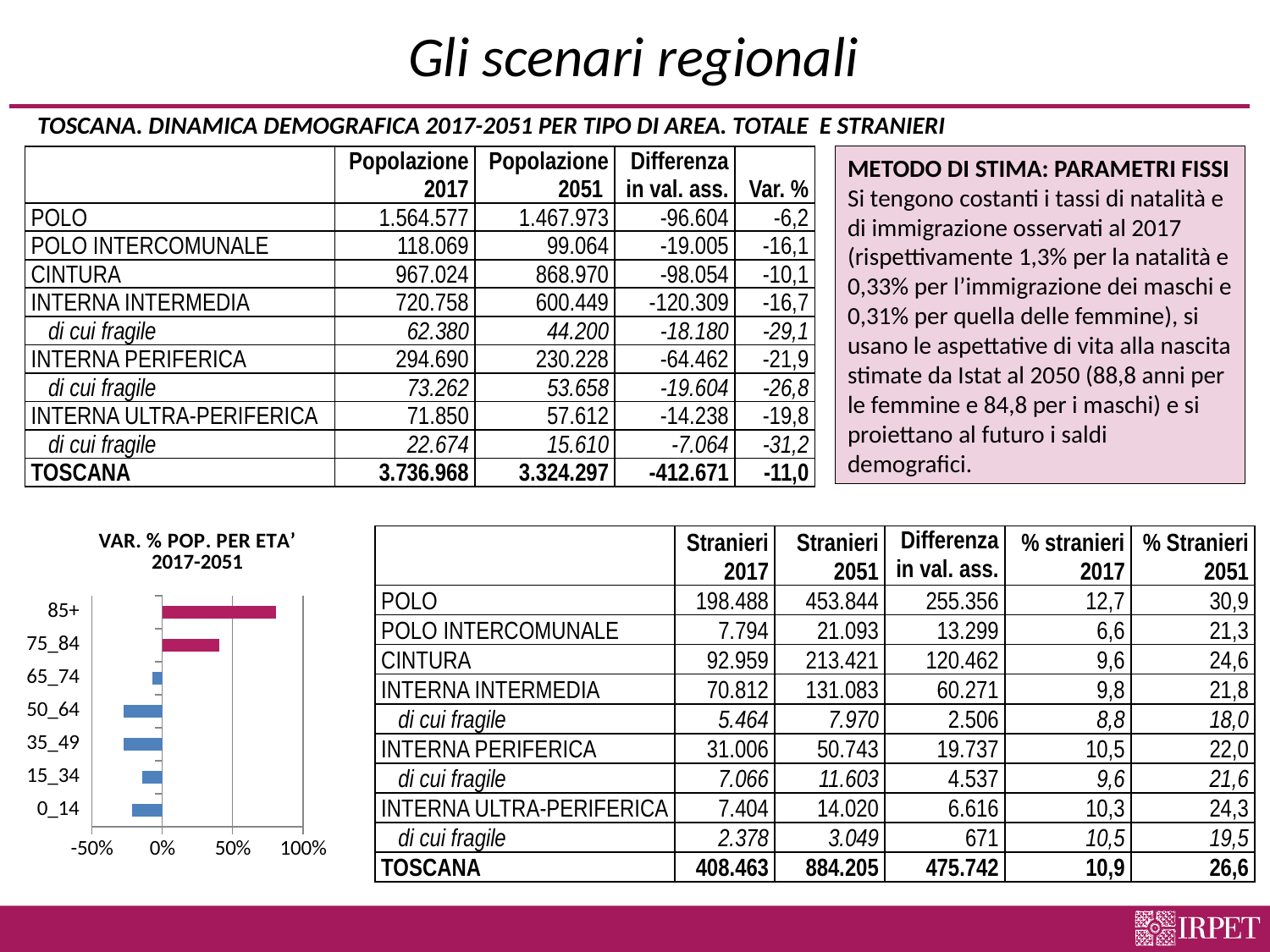
What kind of chart is the 'VAR. % POP. PER ETA' 2017-2051' chart? bar chart In the 'VAR. % POP. PER ETA' 2017-2051' chart, is the value for 85+ greater or less than 50%? greater In the 'VAR. % POP. PER ETA' 2017-2051' chart, is the value for 0_14 greater or less than 0%? less What is the title of the bar chart on the slide? VAR. % POP. PER ETA' 2017-2051 In the 'VAR. % POP. PER ETA' 2017-2051' chart, is the value for 50_64 greater or less than -50%? greater In the 'VAR. % POP. PER ETA' 2017-2051' chart, which has the larger value, 65_74 or 50_64? 65_74 In the 'VAR. % POP. PER ETA' 2017-2051' chart, which has the larger value, 85+ or 75_84? 85+ In the 'VAR. % POP. PER ETA' 2017-2051' chart, which age category has the highest value? 85+ How many age categories are shown in the 'VAR. % POP. PER ETA' 2017-2051' chart? 7 In the 'VAR. % POP. PER ETA' 2017-2051' chart, what colour are the bars with negative values? blue